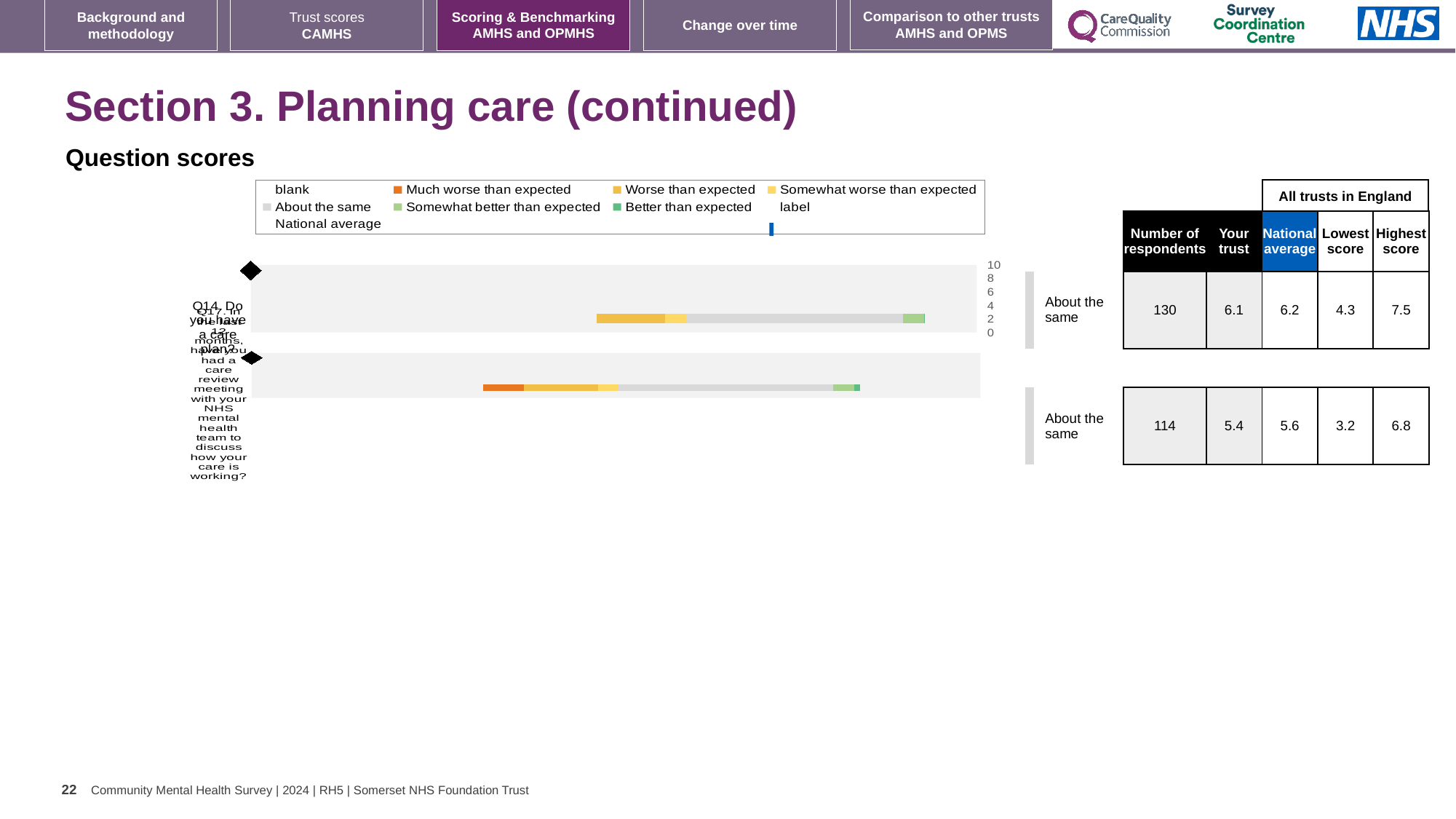
In the table beside the chart, what is the national average for Q14? 6.2 In the table beside the chart, what is the number of respondents for Q17? 114 In the table beside the chart, what is the 'Your trust' score for the second question (Q17)? 5.4 Which colour does the chart legend use for 'Much worse than expected'? orange In the table beside the chart, what is the 'Your trust' score for the first question (Q14)? 6.1 What benchmark category is shown next to the chart for both questions? About the same In the table beside the chart, which question has the higher 'Your trust' score, Q14 or Q17? Q14 In the table beside the chart, what is the difference between the highest score and lowest score for Q14? 3.2 How many questions (categories) are plotted in the chart? 2 What kind of chart is shown under 'Question scores'? bar chart Which colour does the chart legend use for 'Better than expected'? green